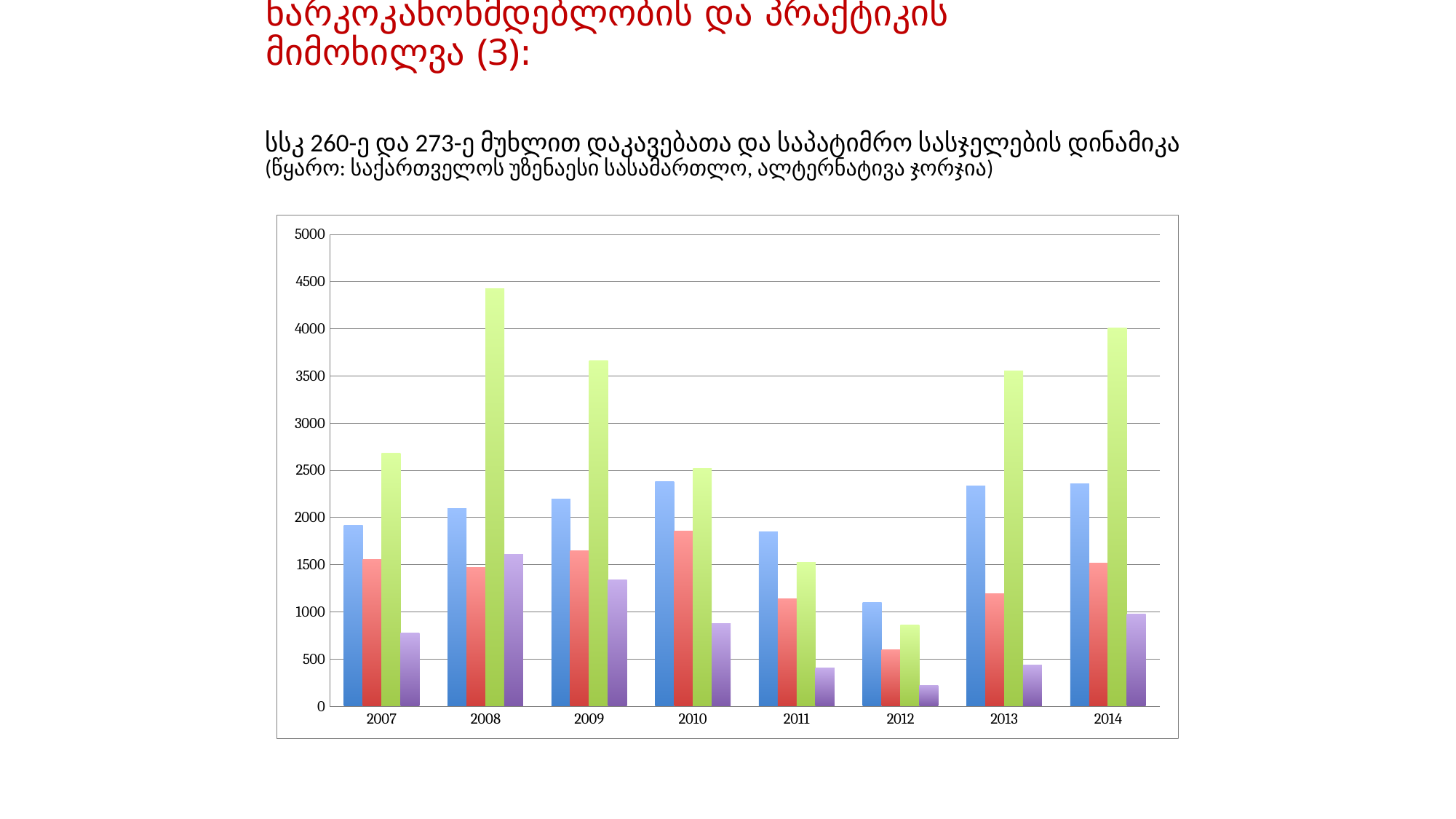
In which year is the red bar the highest? 2010 In which year is the purple bar the lowest? 2012 How many years are shown on the x axis of the chart? 8 In which year is the green bar the lowest? 2012 Is the purple bar for 2012 greater or less than 500? less Is the red bar for 2010 greater or less than 1500? greater What kind of chart is shown on the slide? bar chart In which year is the green bar the highest? 2008 Is the green bar for 2008 greater or less than 4000? greater How many bars are plotted for each year in the chart? 4 Which is larger in 2012, the blue bar or the green bar? the blue bar Do the green bars rise or fall from 2008 to 2012? fall